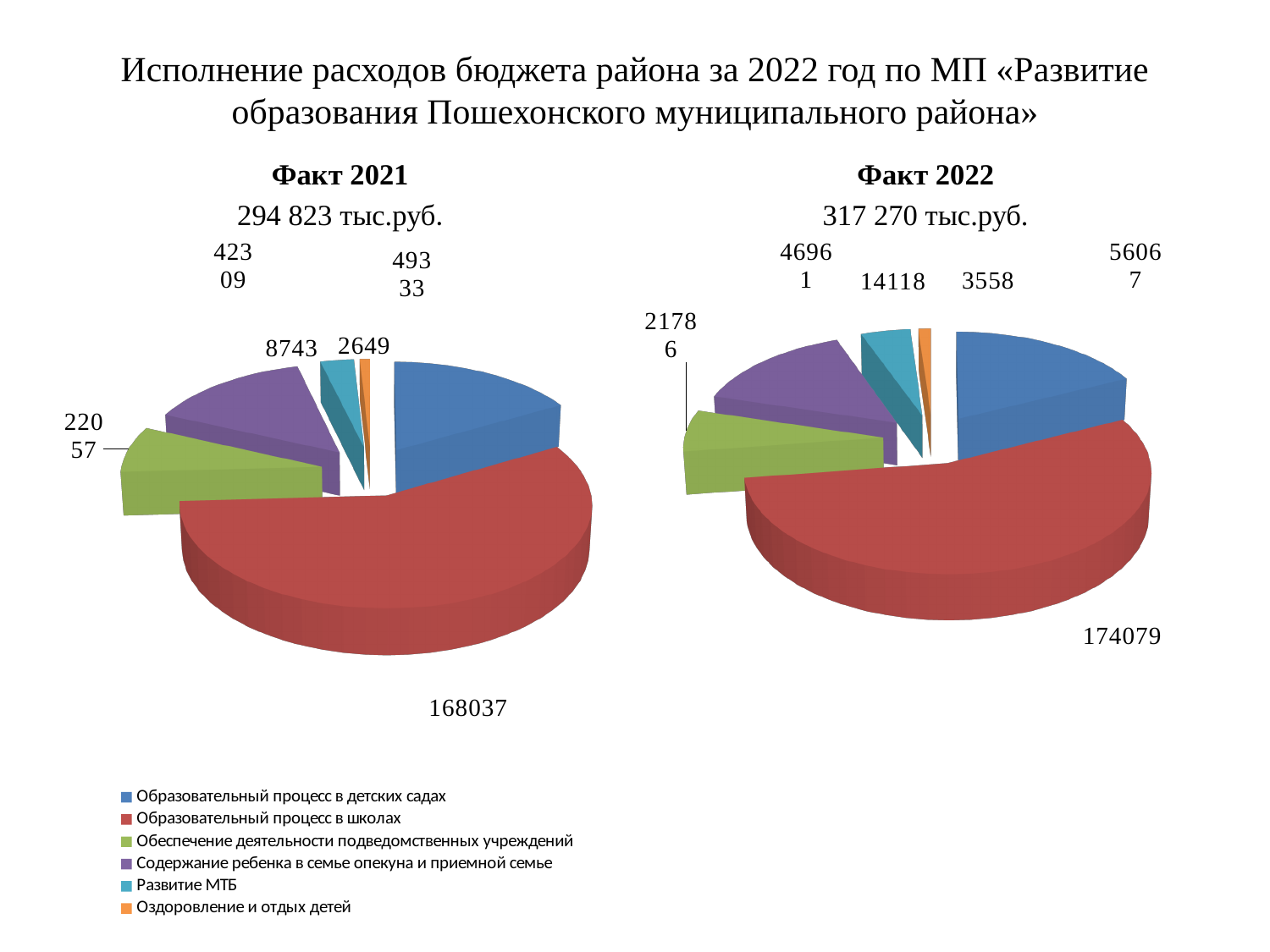
In the Факт 2021 chart, which category has the smallest slice? Оздоровление и отдых детей What kind of chart is used for Факт 2021 and Факт 2022? Pie chart What total amount is shown under the Факт 2022 chart title? 317 270 тыс.руб. By how much does the value for Образовательный процесс в школах in Факт 2022 exceed the value in Факт 2021? 6042 In the Факт 2021 chart, what is the value for Развитие МТБ? 8743 In the Факт 2022 chart, what is the value for Развитие МТБ? 14118 In the Факт 2021 chart, what is the value for Оздоровление и отдых детей? 2649 How many entries does the legend list? 6 In the Факт 2021 chart, what is the value for Образовательный процесс в школах? 168037 In the Факт 2022 chart, what is the value for Образовательный процесс в школах? 174079 In the Факт 2022 chart, which category has the largest slice? Образовательный процесс в школах In the Факт 2022 chart, what is the value for Оздоровление и отдых детей? 3558